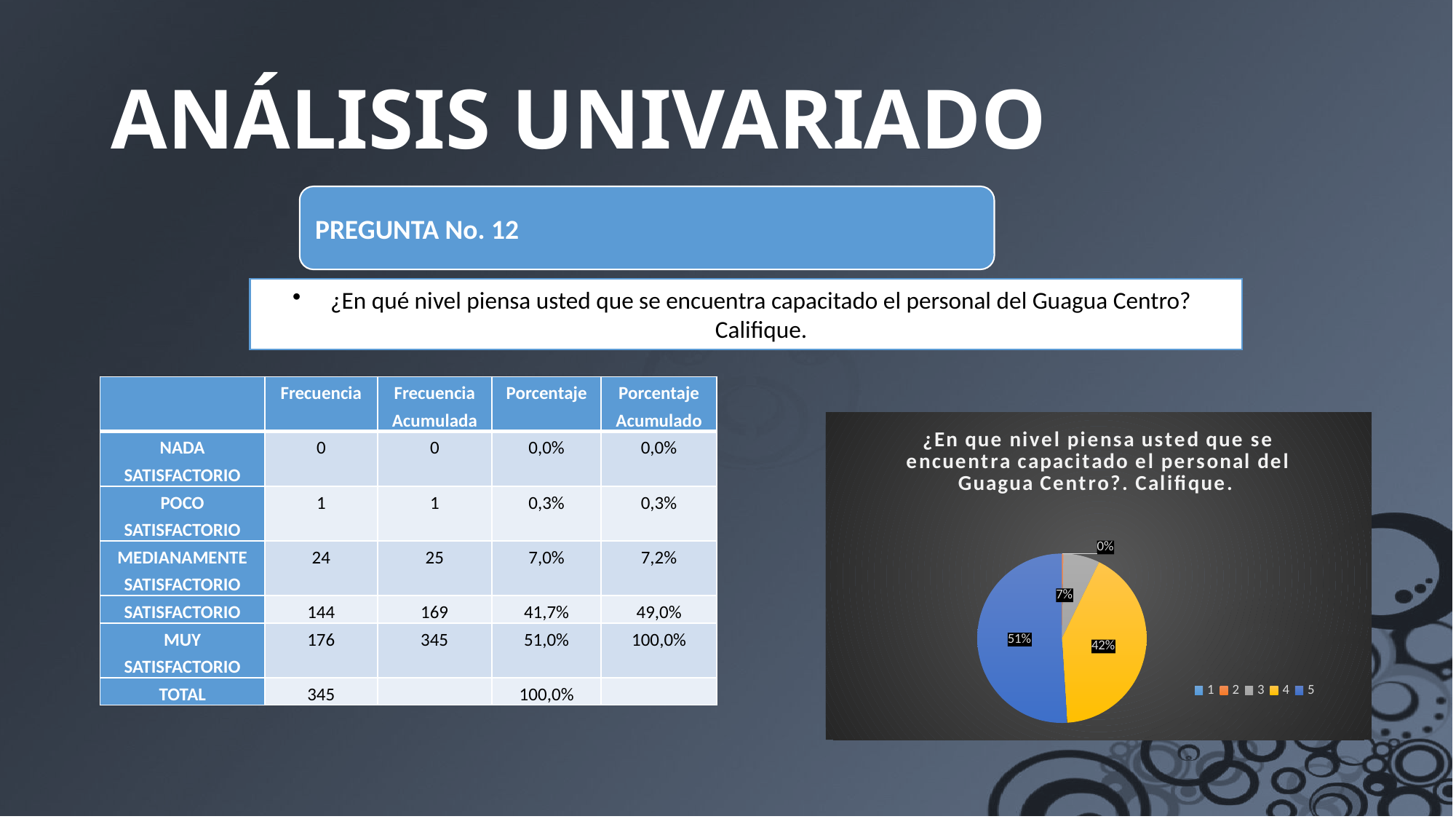
Which legend category has the largest slice in the pie chart? 5 What percentage is shown for the blue slice (category 5) in the pie chart? 51% What is the difference in percentage points between the slice for category 4 and the slice for category 3? 35% What percentage is shown for the gray slice (category 3) in the pie chart? 7% What colour is the slice for category 4 in the pie chart? yellow What kind of chart is shown on the slide? pie chart What percentage is shown for the yellow slice (category 4) in the pie chart? 42% What is the difference in percentage points between the slice for category 5 and the slice for category 4? 9% Which slice is larger in the pie chart, category 4 or category 5? 5 How many entries does the legend of the pie chart list? 5 What is the title of the pie chart? ¿En que nivel piensa usted que se encuentra capacitado el personal del Guagua Centro?. Califique.